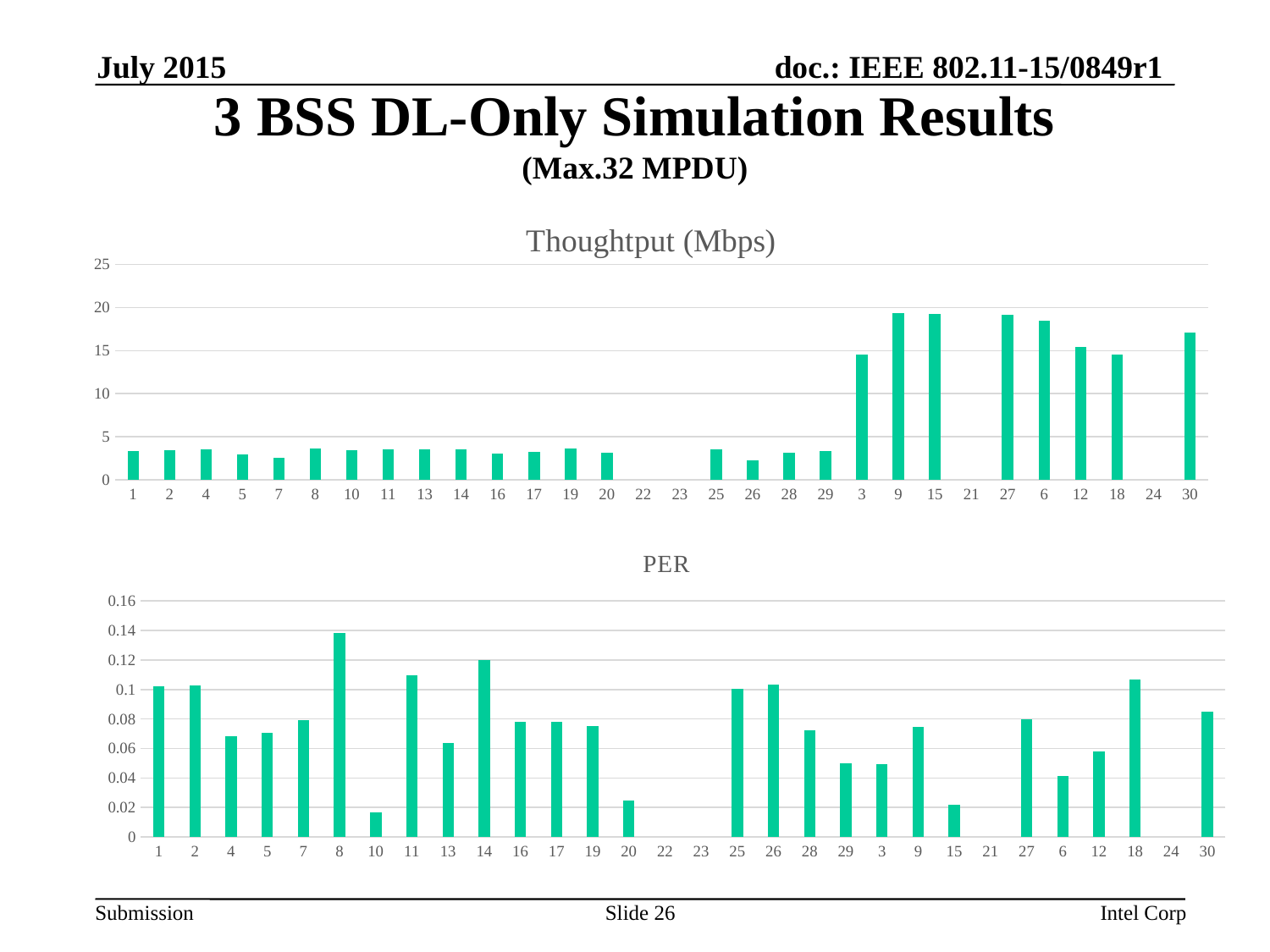
In the 'Thoughtput (Mbps)' chart, is the value for category 3 greater or less than 10? greater What kind of chart is the 'PER' chart? bar chart In the 'PER' chart, is the value for category 8 greater or less than 0.12? greater In the 'PER' chart, which is larger, the value for category 14 or the value for category 13? 14 In the 'Thoughtput (Mbps)' chart, which is larger, the value for category 9 or the value for category 26? 9 In the 'Thoughtput (Mbps)' chart, is the value for category 1 greater or less than 5? less What kind of chart is the 'Thoughtput (Mbps)' chart? bar chart What is the title of the upper chart on the slide? Thoughtput (Mbps) How many categories are shown on the x axis of the 'PER' chart? 30 In the 'PER' chart, which category has the highest value? 8